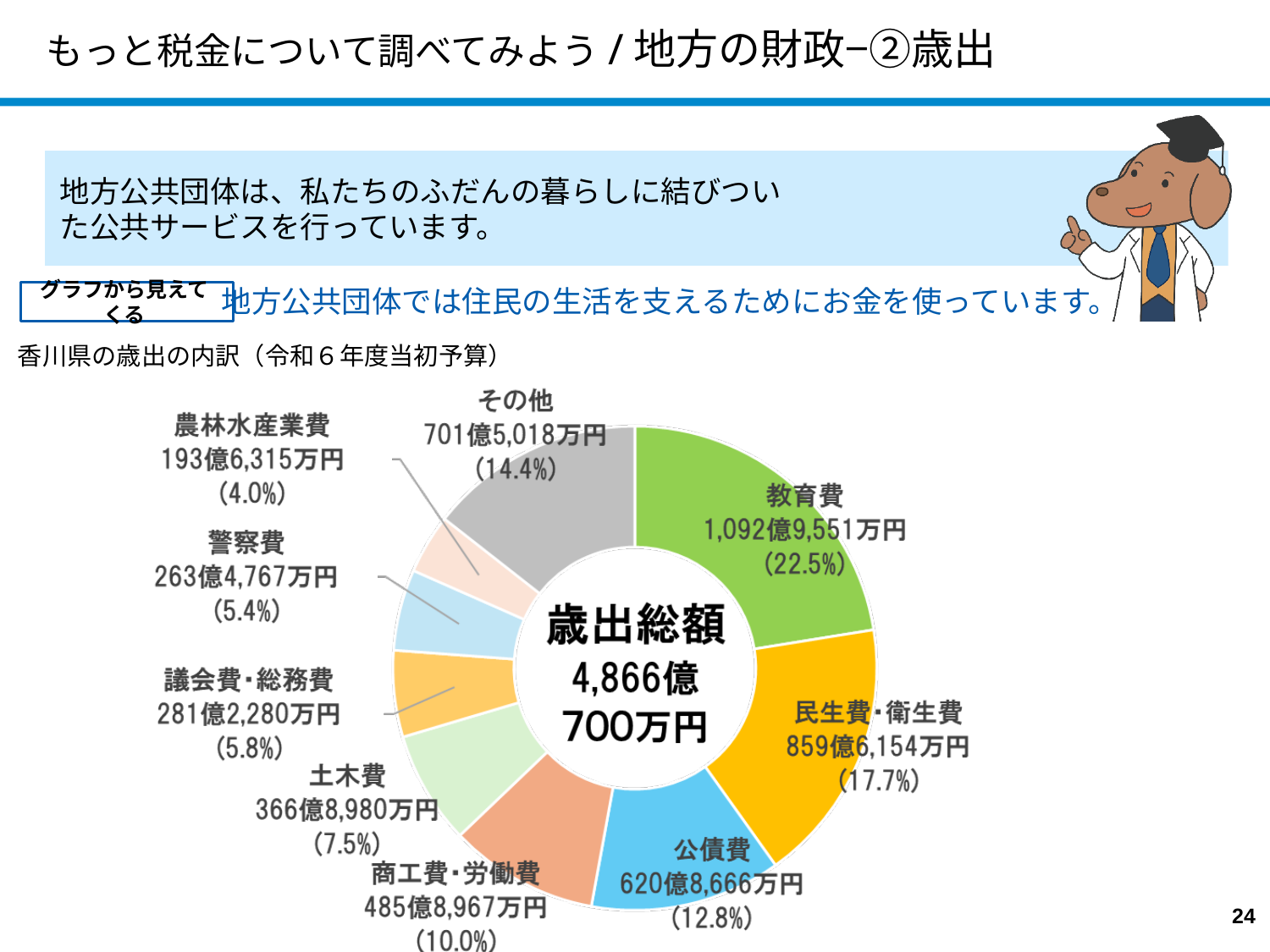
What percentage is shown for 農林水産業費? 4.0% How many categories are shown in the chart? 9 What is the value for 教育費? 1,092億9,551万円 What is the caption above the chart describing what it shows? 香川県の歳出の内訳（令和６年度当初予算） What is the value for 公債費? 620億8,666万円 Which is larger, 土木費 or 警察費? 土木費 What is the difference in percentage points between 教育費 (22.5%) and 公債費 (12.8%)? 9.7 percentage points What is the total expenditure (歳出総額) shown in the centre of the chart? 4,866億700万円 What share of the total does 民生費・衛生費 account for? 17.7% Which category has the largest share of the expenditure? 教育費 Which category has the smallest share of the expenditure? 農林水産業費 What kind of chart is shown on the slide? Pie (donut) chart